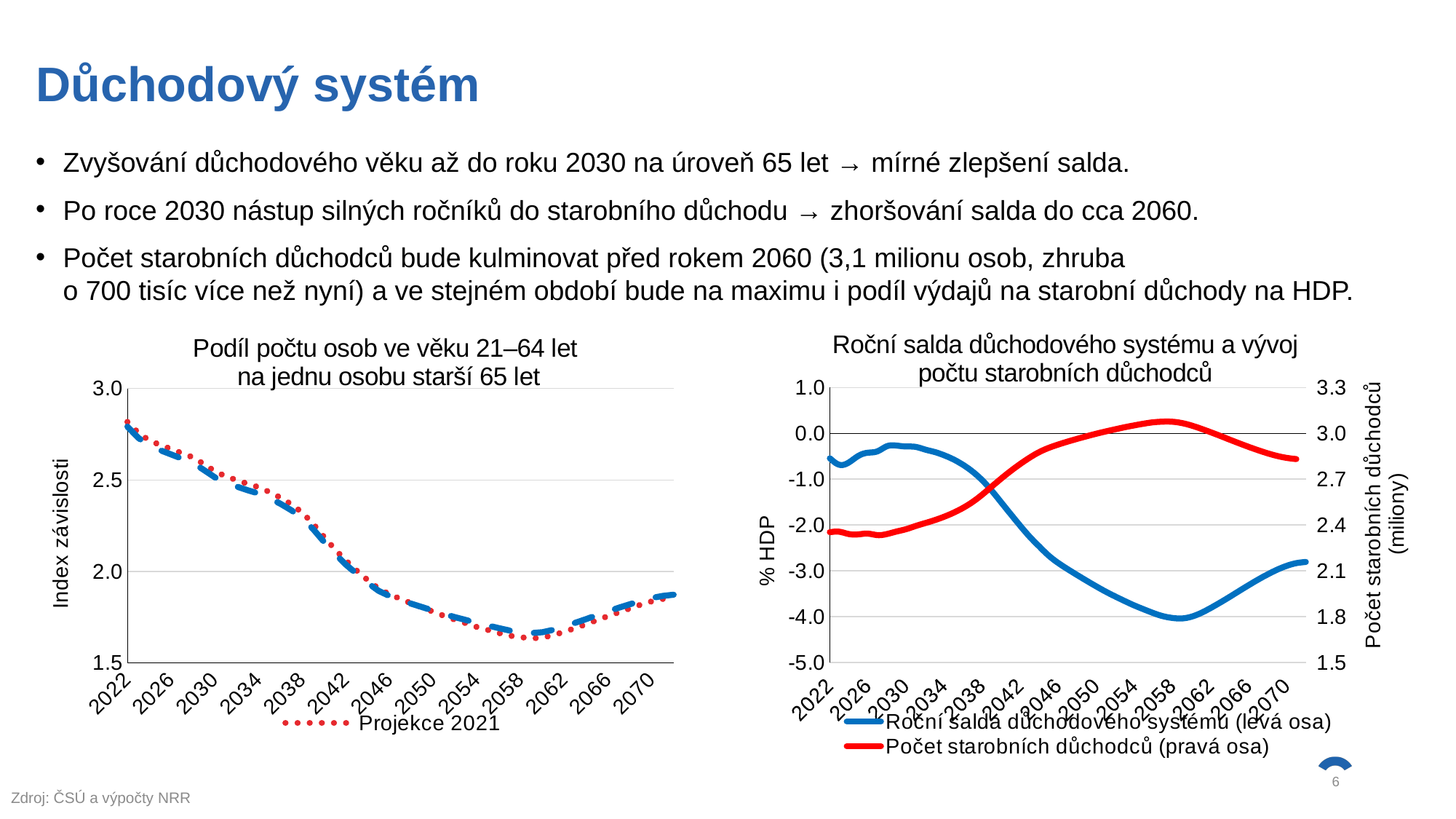
In the left chart, which is larger, the value for 2022 or the value for 2070? 2022 In the left chart, does the dependency index rise or fall between 2022 and 2058? fall What kind of chart is the left chart titled 'Podíl počtu osob ve věku 21–64 let na jednu osobu starší 65 let'? line chart In the right chart, how many series does the legend list? 2 In the right chart, is the value of 'Roční salda důchodového systému (levá osa)' for 2060 greater or less than -3.0? less In the left chart, is the value for 2022 greater or less than 2.5? greater What kind of chart is the right chart titled 'Roční salda důchodového systému a vývoj počtu starobních důchodců'? line chart In the left chart, is the value for 2058 greater or less than 2.0? less What is the label of the left vertical axis of the right chart? % HDP In the right chart, does 'Počet starobních důchodců (pravá osa)' rise or fall between 2022 and 2058? rise